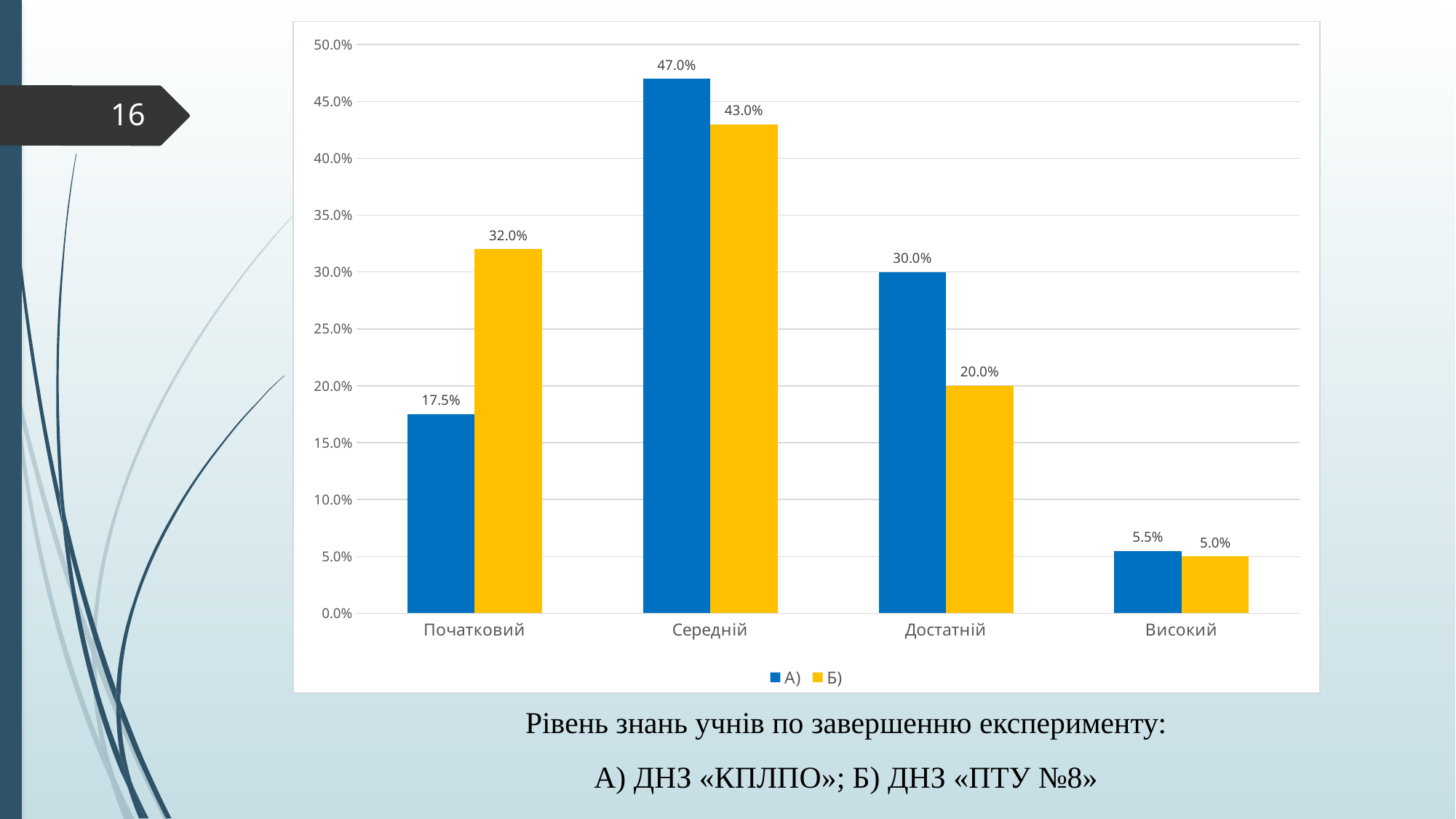
What is the value for series Б) in the Середній category? 43.0% What kind of chart is shown on the slide? Bar chart How many series does the legend list? 2 What is the difference between series Б) and series А) in the Початковий category? 14.5% What is the value for series А) in the Початковий category? 17.5% Which category has the highest value for series А)? Середній Which series has the larger value in the Середній category, А) or Б)? А) How many categories are shown on the x axis? 4 What is the value for series Б) in the Достатній category? 20.0% What is the difference between series А) and series Б) in the Достатній category? 10.0% Which colour represents series Б) in the chart? Yellow Which category has the lowest value for series Б)? Високий